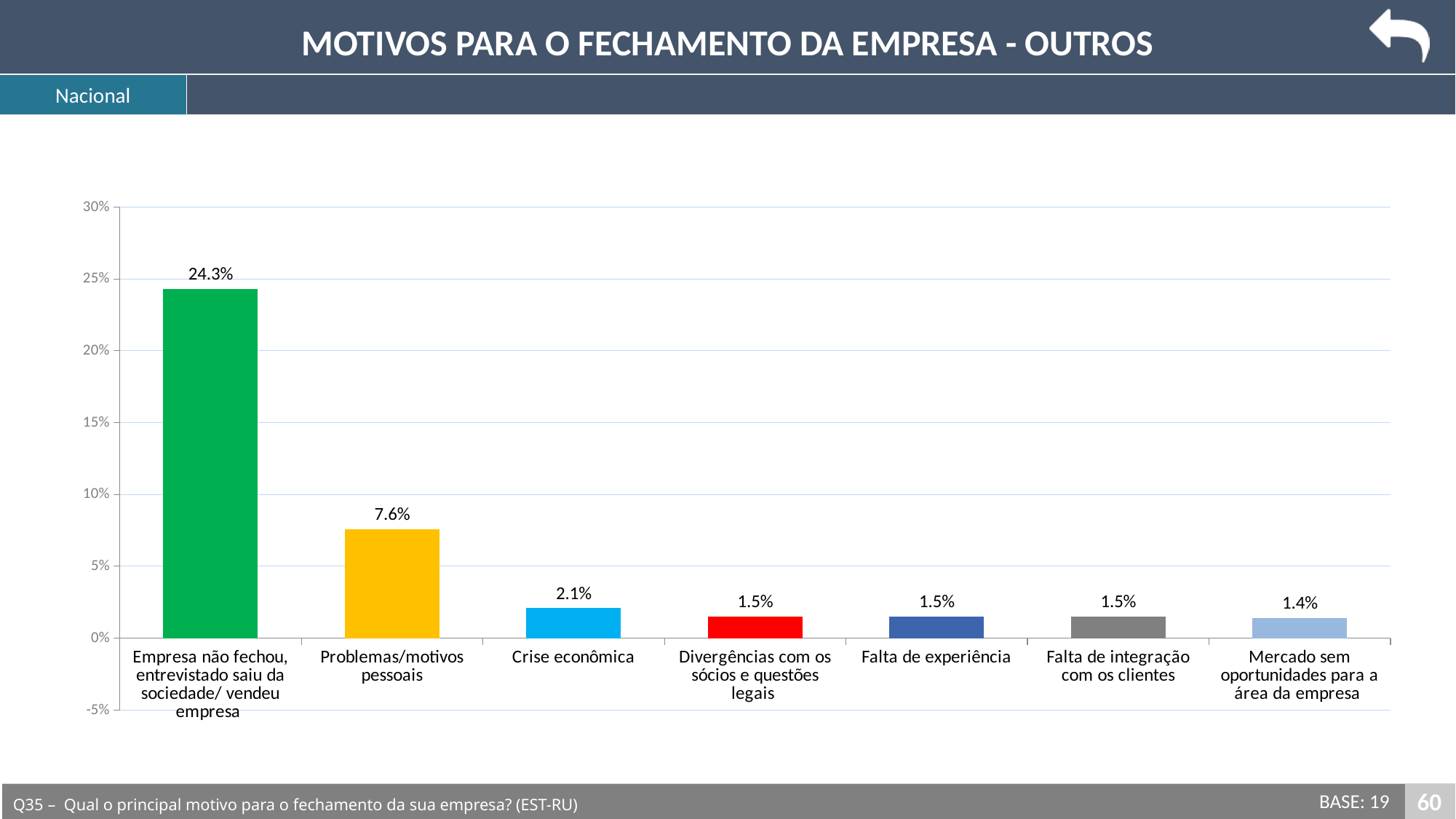
Which is larger, the value for "Problemas/motivos pessoais" or the value for "Crise econômica"? Problemas/motivos pessoais What is the difference between the values for "Empresa não fechou, entrevistado saiu da sociedade/ vendeu empresa" and "Problemas/motivos pessoais"? 16.7% What kind of chart is shown on the slide? Bar chart What is the value for "Crise econômica"? 2.1% What is the value for "Problemas/motivos pessoais"? 7.6% Is the value for "Empresa não fechou, entrevistado saiu da sociedade/ vendeu empresa" greater or less than 20%? greater Is the value for "Problemas/motivos pessoais" greater or less than 10%? less How many categories are shown in the chart? 7 Which category has the highest value? Empresa não fechou, entrevistado saiu da sociedade/ vendeu empresa What is the base (number of respondents) shown on the slide? 19 What is the value for "Mercado sem oportunidades para a área da empresa"? 1.4% What is the difference between the values for "Crise econômica" and "Falta de experiência"? 0.6%